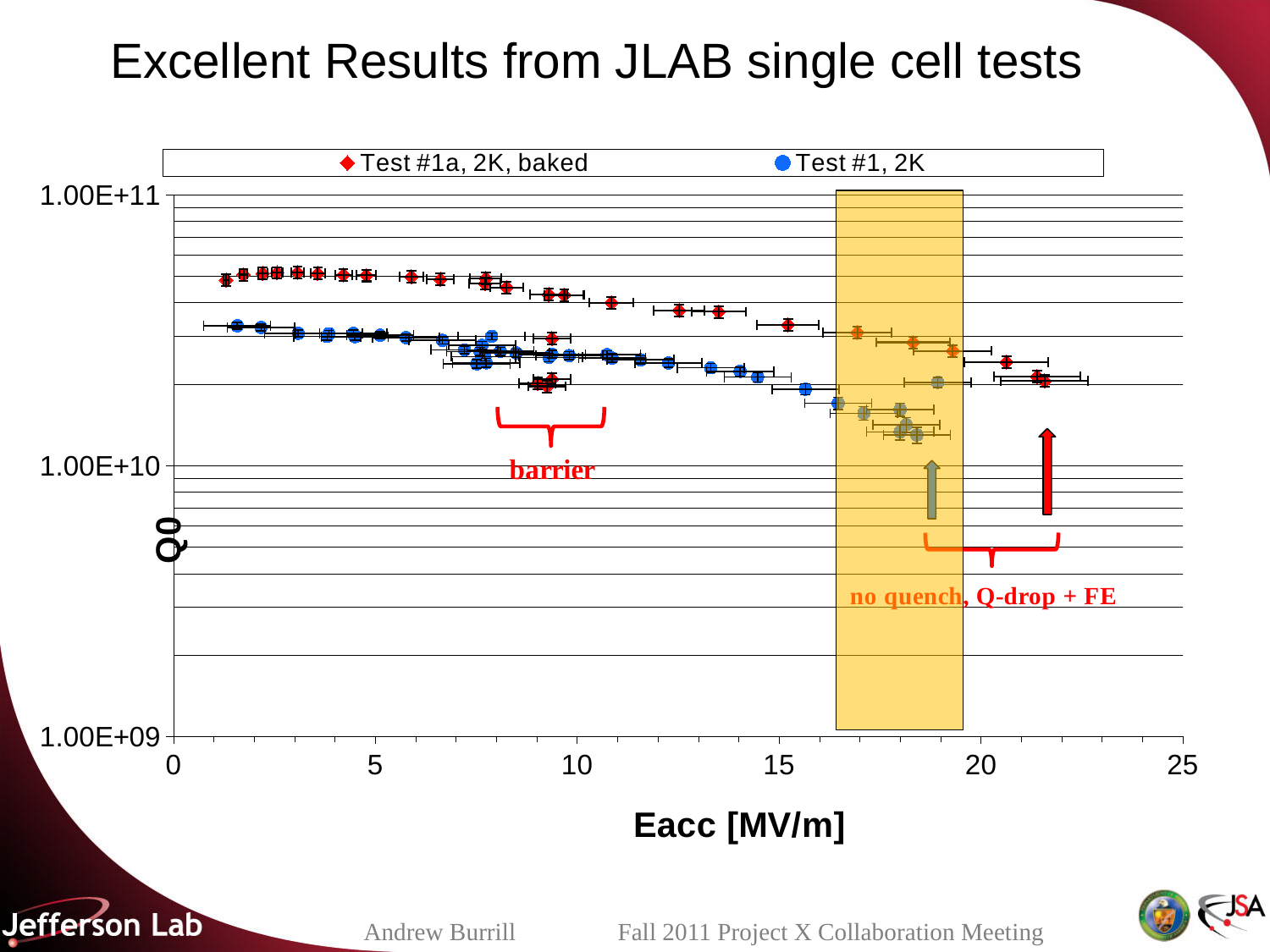
What is the label of the x axis? Eacc [MV/m] Which series reaches the higher maximum Eacc value? Test #1a, 2K, baked Is the Q0 value of the Test #1a, 2K, baked series at Eacc of 5 MV/m greater or less than 1.00E+10? greater Is the Q0 value of the Test #1, 2K series at Eacc of 15 MV/m greater or less than 1.00E+10? greater How many series does the legend list? 2 Do the Q0 values of the Test #1, 2K series rise or fall as Eacc increases? fall Is the Q0 value of the Test #1, 2K series at Eacc of 10 MV/m greater or less than 1.00E+11? less Do the Q0 values of the Test #1a, 2K, baked series rise or fall as Eacc increases? fall At Eacc of 5 MV/m, which series has the higher Q0: Test #1a, 2K, baked or Test #1, 2K? Test #1a, 2K, baked Which series is plotted with red diamond markers? Test #1a, 2K, baked What kind of chart is shown on the slide? scatter chart What is the highest value shown on the x axis? 25